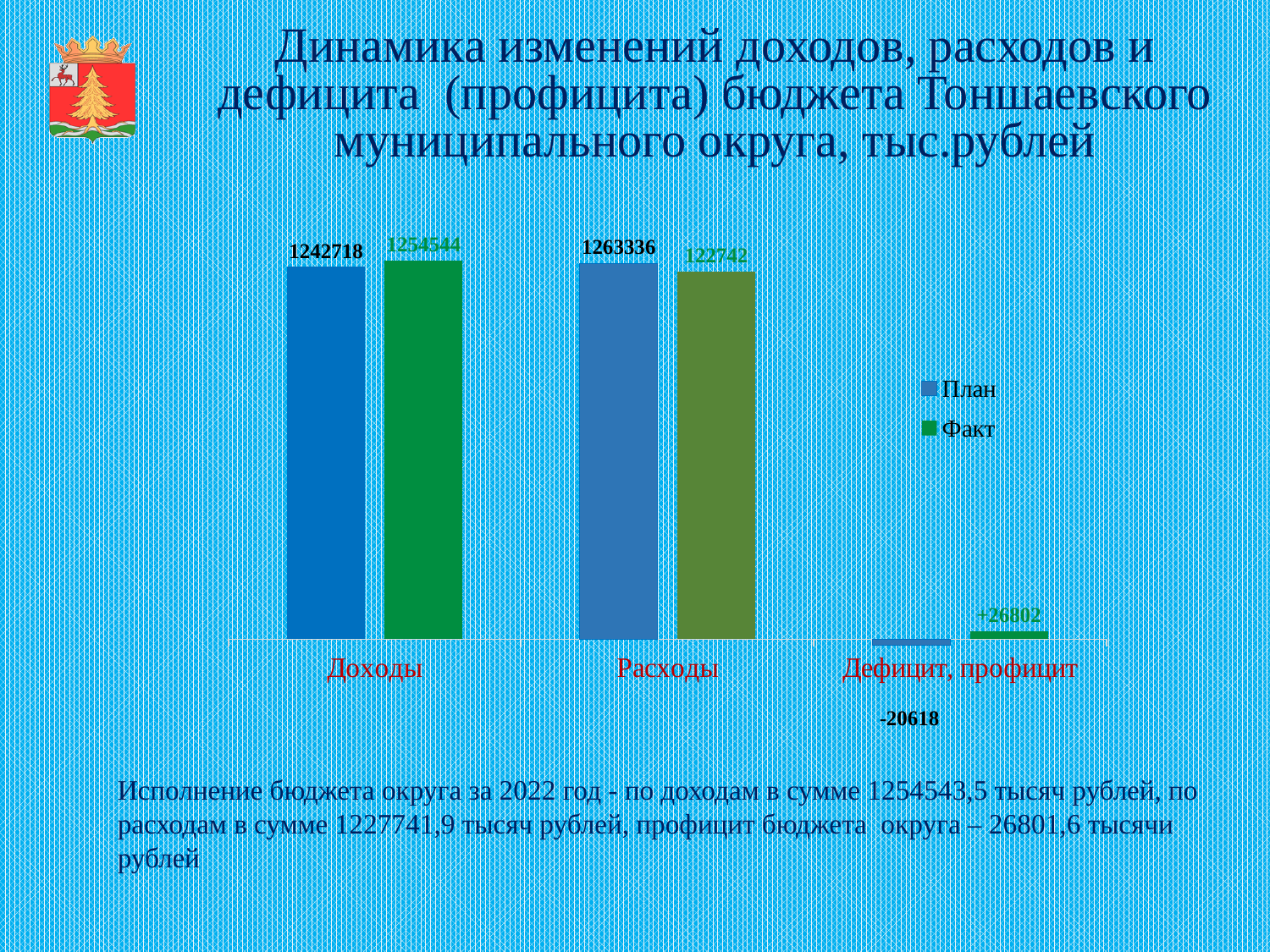
What is the Факт value for Доходы? 1254544 How many series does the legend list? 2 Which category has the highest План value? Расходы What is the difference between the План and Факт values for Расходы? 35594 Is the Факт value for Доходы larger or smaller than the План value for Доходы? larger What is the План value for Дефицит, профицит? -20618 What kind of chart is shown on the slide? bar chart What is the План value for Доходы? 1242718 Which category has the lowest Факт value? Дефицит, профицит What is the План value for Расходы? 1263336 What is the Факт value for Дефицит, профицит? +26802 What is the Факт value for Расходы? 1227742